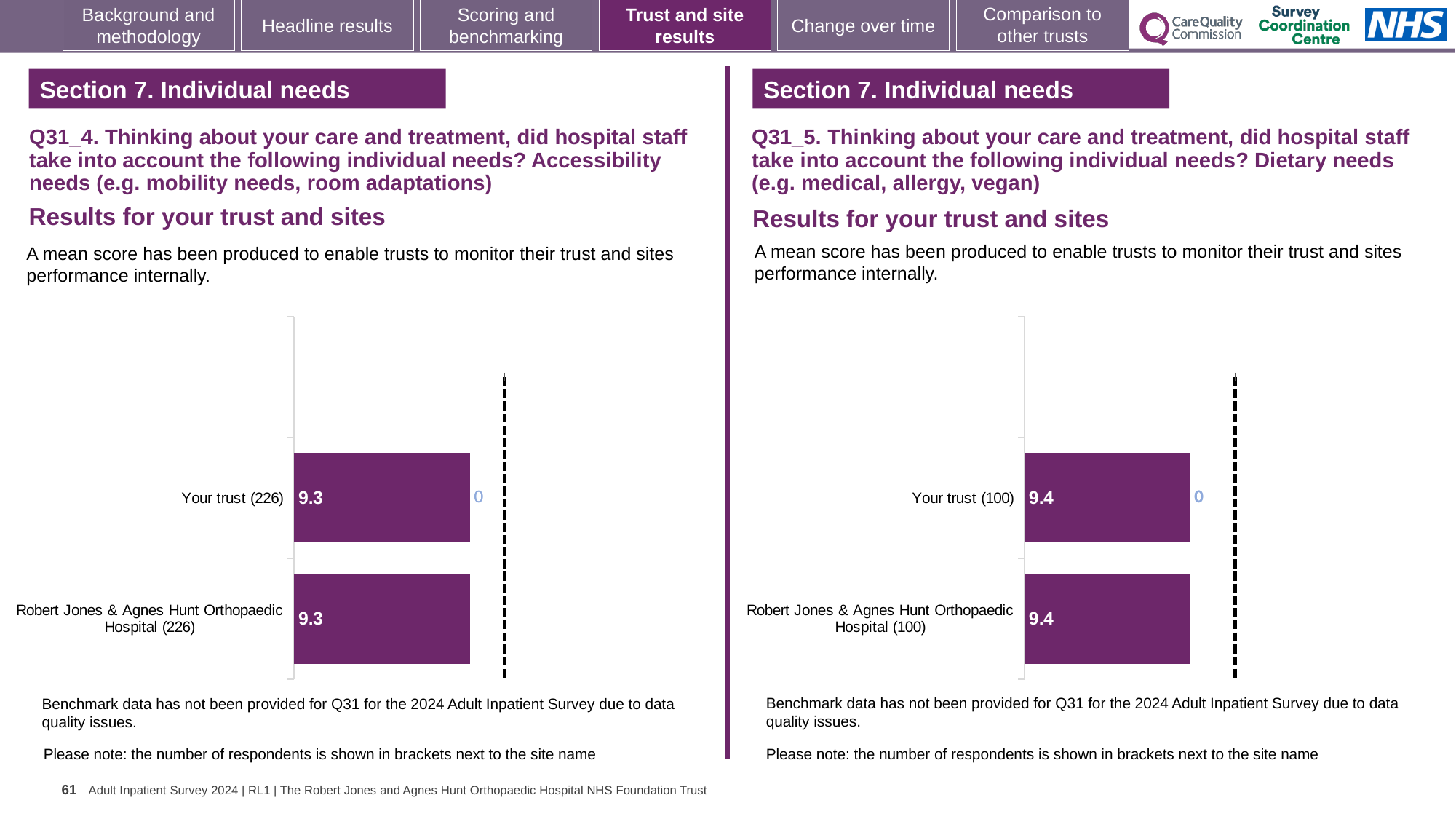
On the left chart (Q31_4, accessibility needs), what is the difference between the score for Your trust and the score for Robert Jones & Agnes Hunt Orthopaedic Hospital? 0 On the left chart (Q31_4, accessibility needs), what is the mean score for Robert Jones & Agnes Hunt Orthopaedic Hospital (226)? 9.3 What kind of chart is used on the left side of the slide for Q31_4? Bar chart Is the score for Your trust on the right chart (Q31_5, dietary needs) higher or lower than the score for Your trust on the left chart (Q31_4, accessibility needs)? Higher On the right chart (Q31_5, dietary needs), what is the mean score for Robert Jones & Agnes Hunt Orthopaedic Hospital (100)? 9.4 On the right chart (Q31_5), how many respondents are shown in brackets for Robert Jones & Agnes Hunt Orthopaedic Hospital? 100 How many bars are plotted on the left chart (Q31_4, accessibility needs)? 2 On the left chart (Q31_4), how many respondents are shown in brackets for Your trust? 226 On the left chart (Q31_4, accessibility needs), what is the mean score for Your trust (226)? 9.3 On the right chart (Q31_5, dietary needs), what is the mean score for Your trust (100)? 9.4 On the right chart (Q31_5, dietary needs), what is the difference between the score for Your trust and the score for Robert Jones & Agnes Hunt Orthopaedic Hospital? 0 How many bars are plotted on the right chart (Q31_5, dietary needs)? 2